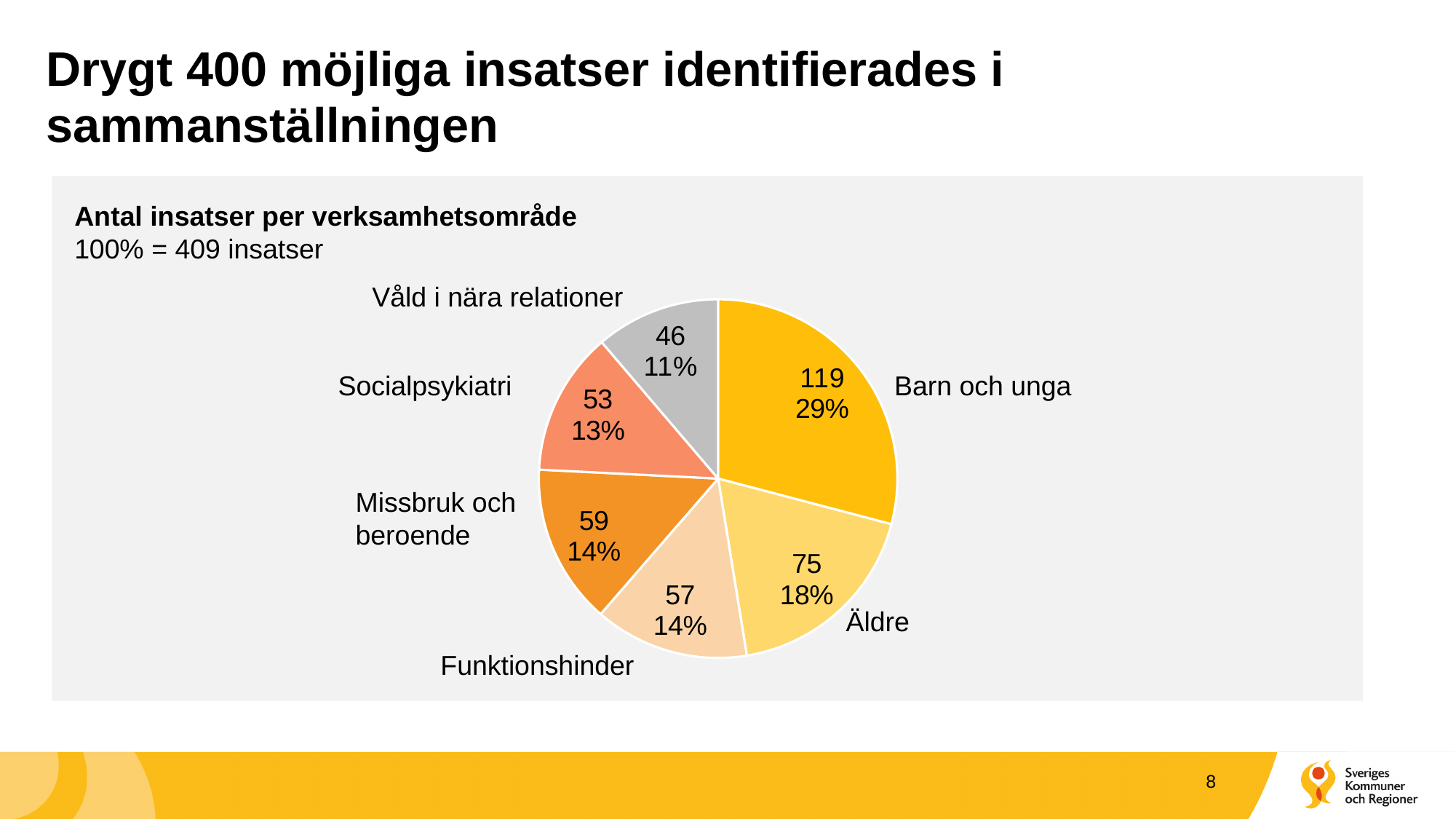
Which verksamhetsområde has the smallest number of insatser? Våld i nära relationer What kind of chart is shown on the slide? Pie chart What is the title of the chart? Antal insatser per verksamhetsområde How many insatser are shown for Barn och unga? 119 What is the difference in insatser between Barn och unga and Äldre? 44 According to the chart subtitle, how many insatser correspond to 100%? 409 insatser How many insatser are shown for Socialpsykiatri? 53 What percentage share does Äldre have in the pie chart? 18% What percentage share does Våld i nära relationer have? 11% Which has more insatser, Missbruk och beroende or Funktionshinder? Missbruk och beroende How many categories (slices) does the pie chart have? 6 Which verksamhetsområde has the largest number of insatser? Barn och unga